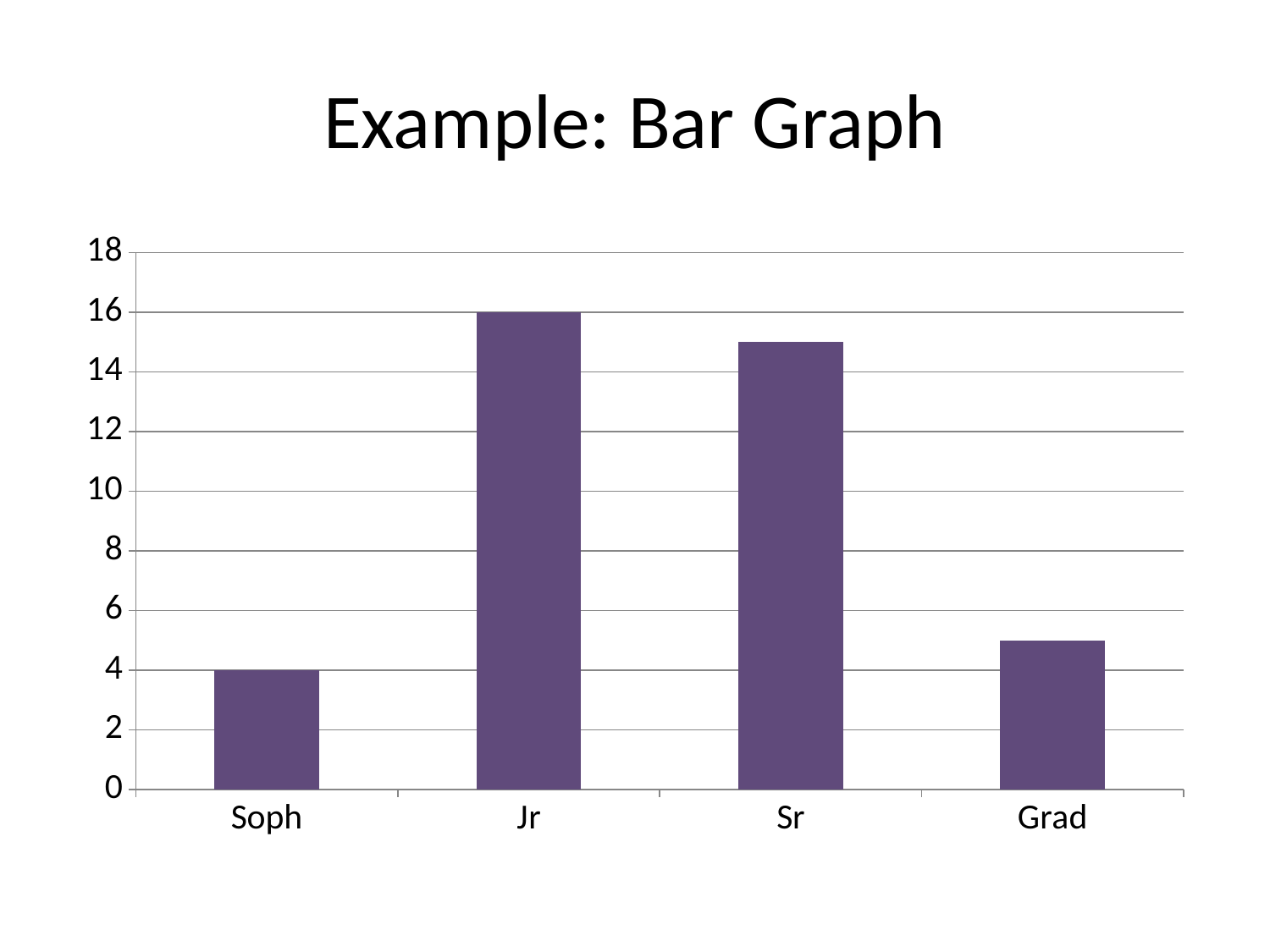
How many categories are shown on the x axis? 4 Is the value for Sr greater or less than 14? greater Which category has the highest bar? Jr Which category has the lowest bar? Soph Is the value for Grad greater or less than 6? less What is the difference between the values for Jr and Soph? 12 What is the title of the slide? Example: Bar Graph What is the value for Jr? 16 What is the value for Soph? 4 Which is larger, the value for Soph or the value for Grad? Grad What kind of chart is shown on the slide? bar chart Which is larger, the value for Jr or the value for Sr? Jr